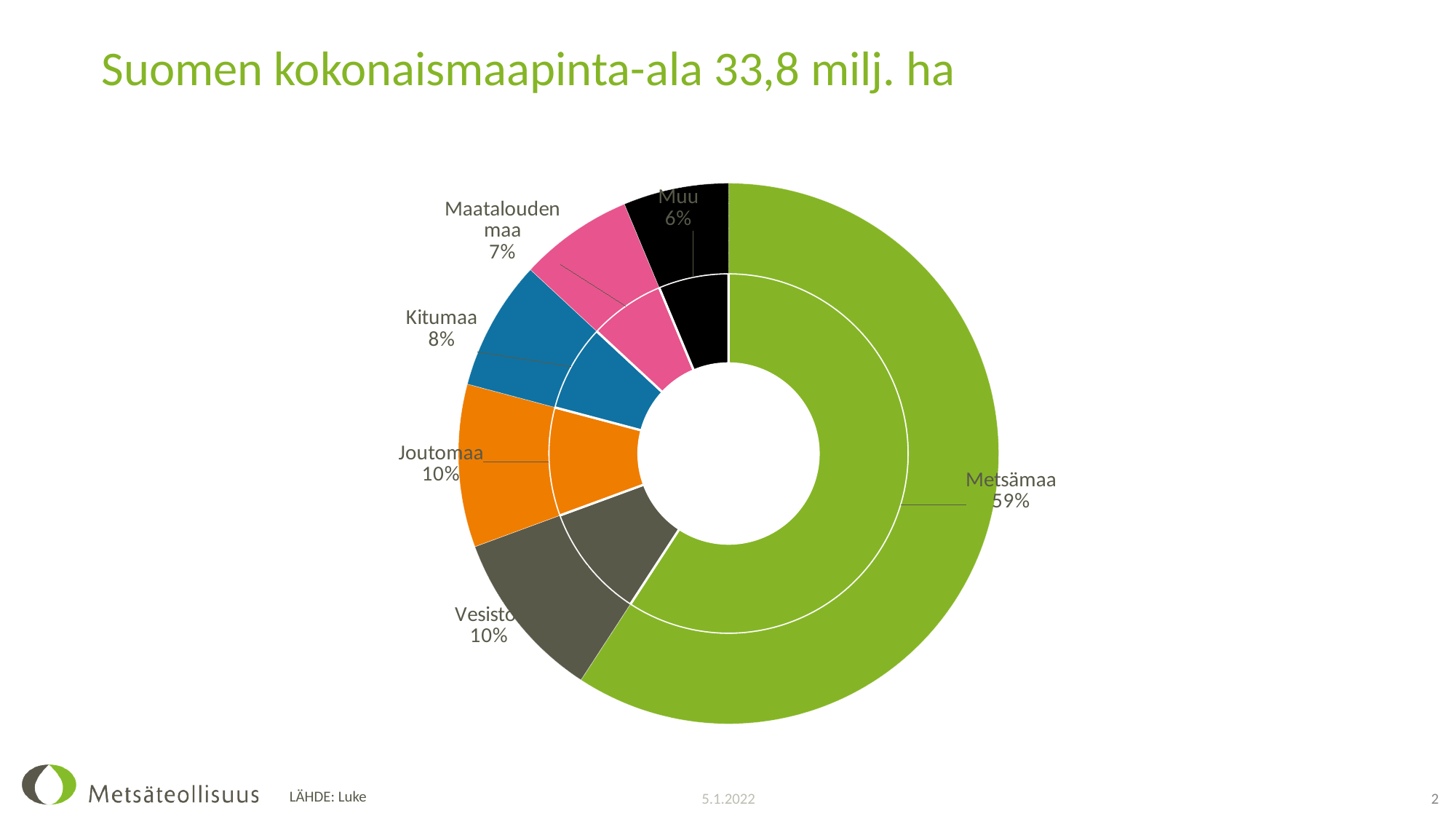
What percentage is shown for Muu? 6% What is the title of the slide? Suomen kokonaismaapinta-ala 33,8 milj. ha Which is larger, the share for Kitumaa or the share for Maatalouden maa? Kitumaa What percentage is shown for Maatalouden maa? 7% Which category has the smallest share of the chart? Muu What share of the chart does Metsämaa account for? 59% Which category has the largest share of the chart? Metsämaa What is the difference in percentage points between Kitumaa and Muu? 2 What percentage is shown for Kitumaa? 8% What kind of chart is shown on the slide? Doughnut chart What is the difference in percentage points between Metsämaa and Vesistö? 49 How many categories are shown in the chart? 6